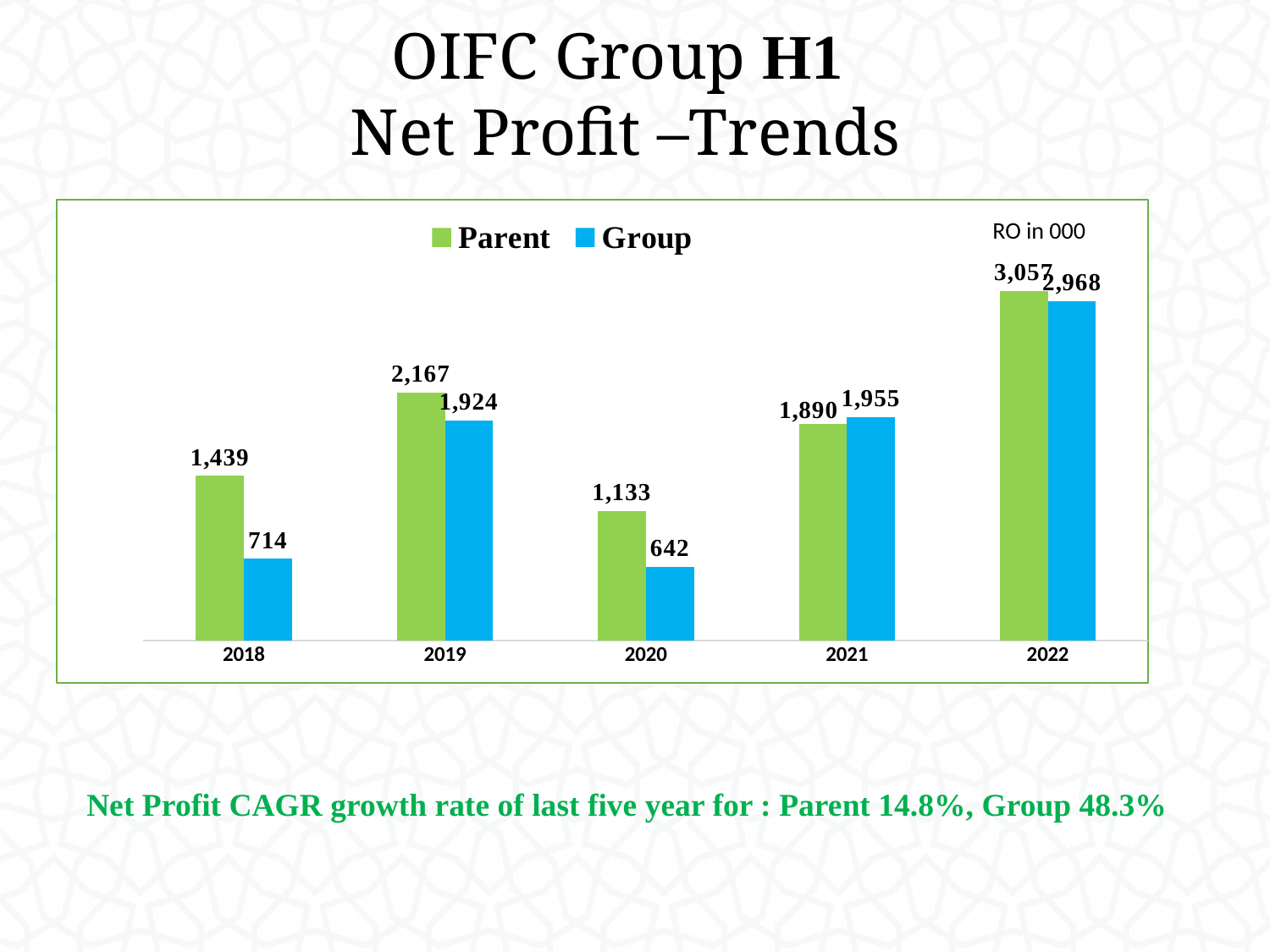
Does the Group value rise or fall from 2021 to 2022? Rise What is the Group value for 2021? 1,955 What unit is indicated in the top right corner of the chart? RO in 000 What is the Group net profit value for 2020? 642 What is the difference between the Parent and Group values in 2018? 725 How many years are shown on the x axis? 5 Which year has the highest Parent value? 2022 What kind of chart is shown on the slide? Bar chart How many series does the legend list? 2 What is the Parent net profit value for 2018? 1,439 Which year has the lowest Group value? 2020 In 2021, which is larger, the Parent value or the Group value? Group